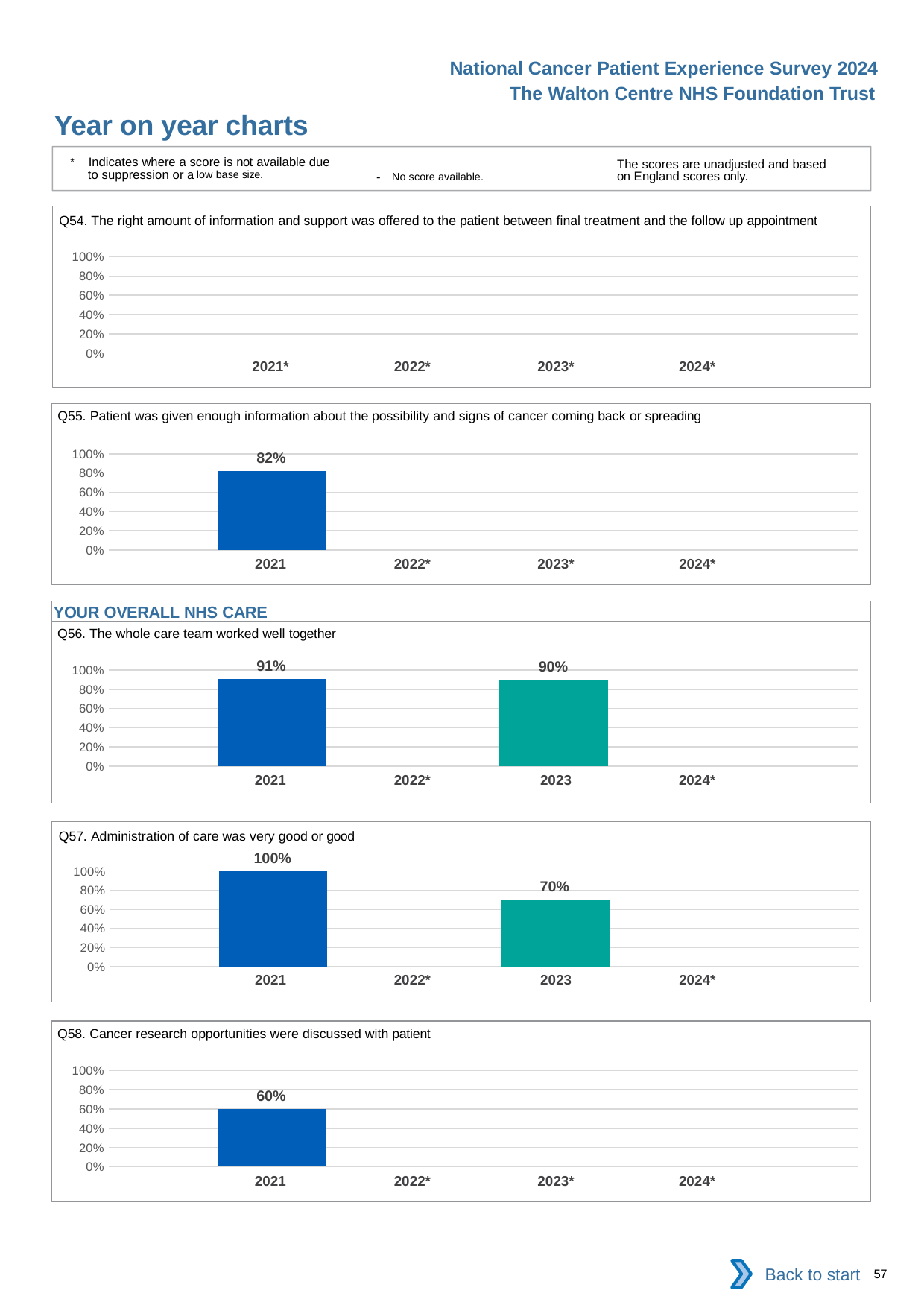
What kind of chart is the Q58 chart? Bar chart In the Q57 chart, what is the value for 2021? 100% In the Q57 chart, what is the value for 2023? 70% In the Q56 chart, what is the value for 2023? 90% How many bars are plotted in the Q54 chart? 0 How many years are shown on the x axis of the Q54 chart? 4 In the Q57 chart, which year has the higher value, 2021 or 2023? 2021 In the Q57 chart, what is the difference between the 2021 and 2023 values? 30 percentage points In the Q56 chart, what is the difference between the 2021 and 2023 values? 1 percentage point In the Q56 chart, what is the value for 2021? 91% In the Q58 chart, what is the value for 2021? 60% In the Q55 chart, what is the value for 2021? 82%